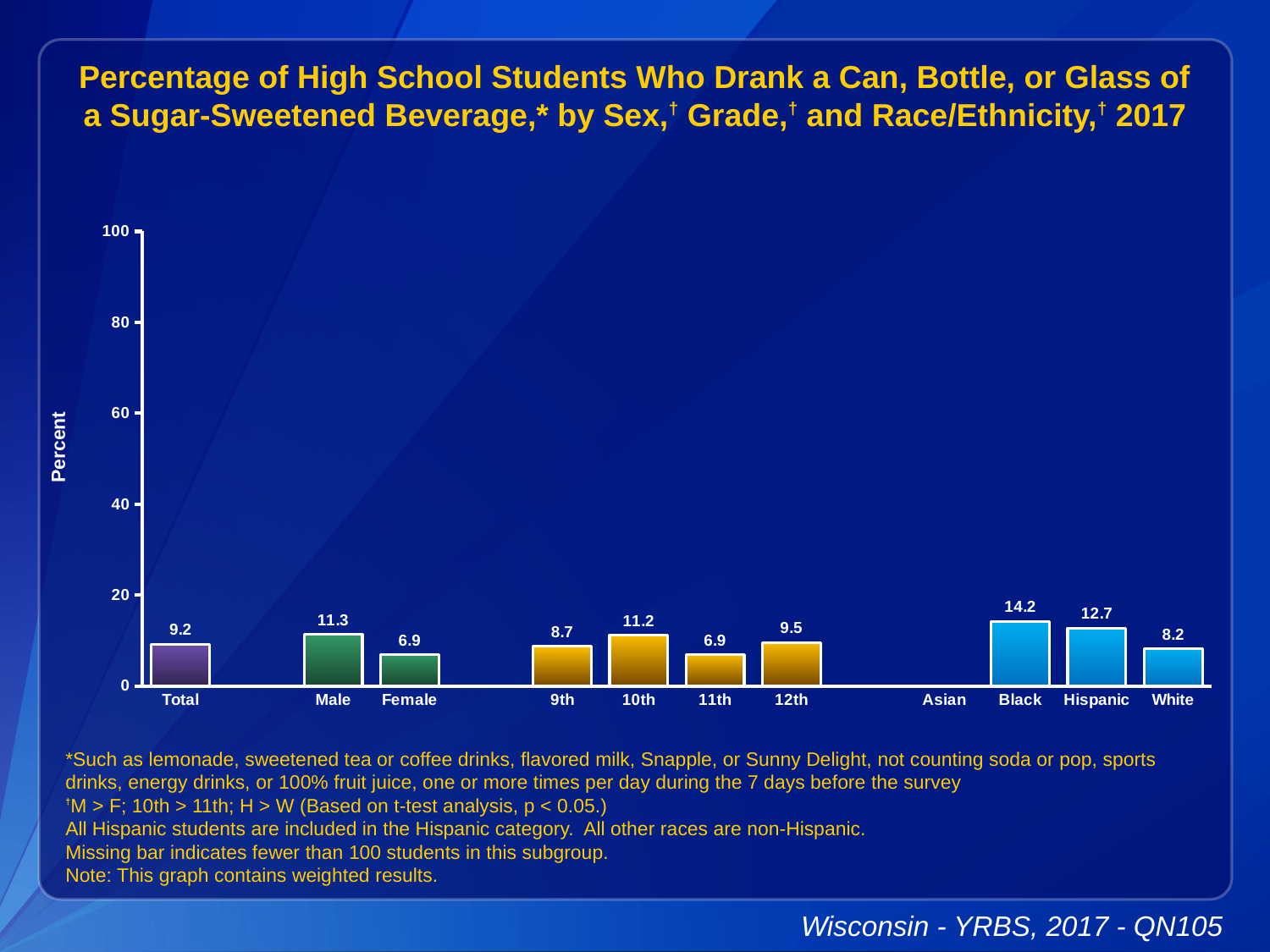
What is the difference between the Black and White values? 6.0 What is the value for 10th grade? 11.2 Which category has no bar shown? Asian How many bars are plotted on the chart? 10 What is the difference between the Male and Female values? 4.4 What kind of chart is shown? bar chart Which category has the highest value? Black What is the value for Total? 9.2 Which is larger, the value for 9th grade or 12th grade? 12th Is the value for Black greater or less than 20? less What is the value for Hispanic students? 12.7 What is the value for Male? 11.3